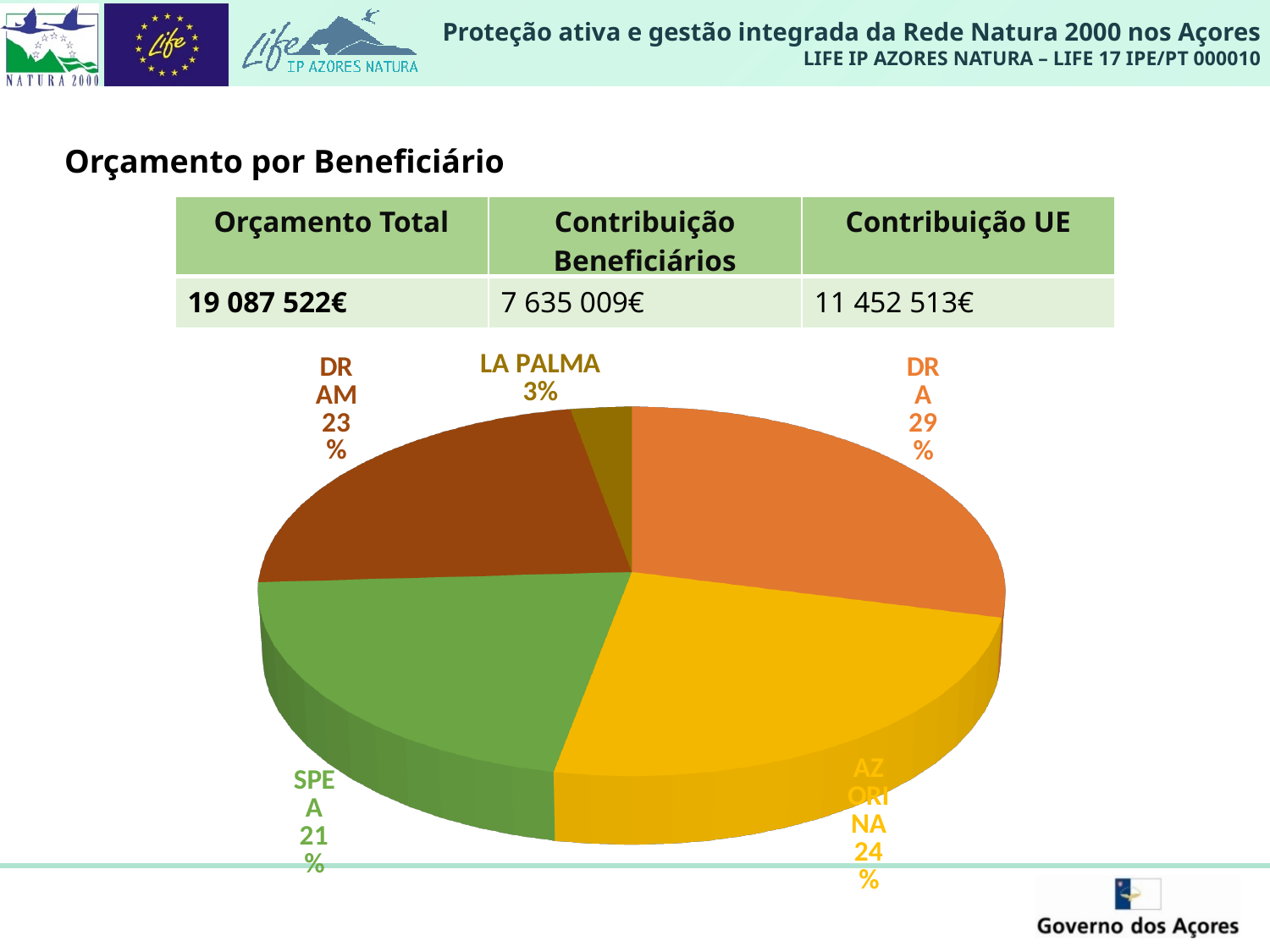
Which slice is larger, DRAM or LA PALMA? DRAM What share of the pie does DRA hold? 29% Which beneficiary has the smallest slice of the pie? LA PALMA How many slices does the pie chart have? 5 What share of the pie does SPEA hold? 21% What share of the pie does DRAM hold? 23% What share of the pie does AZORINA hold? 24% What share of the pie does LA PALMA hold? 3% What is the difference in percentage points between the DRA slice and the SPEA slice? 8 What colour is the AZORINA slice of the pie? yellow Which beneficiary has the largest slice of the pie? DRA What kind of chart is shown on the slide? pie chart